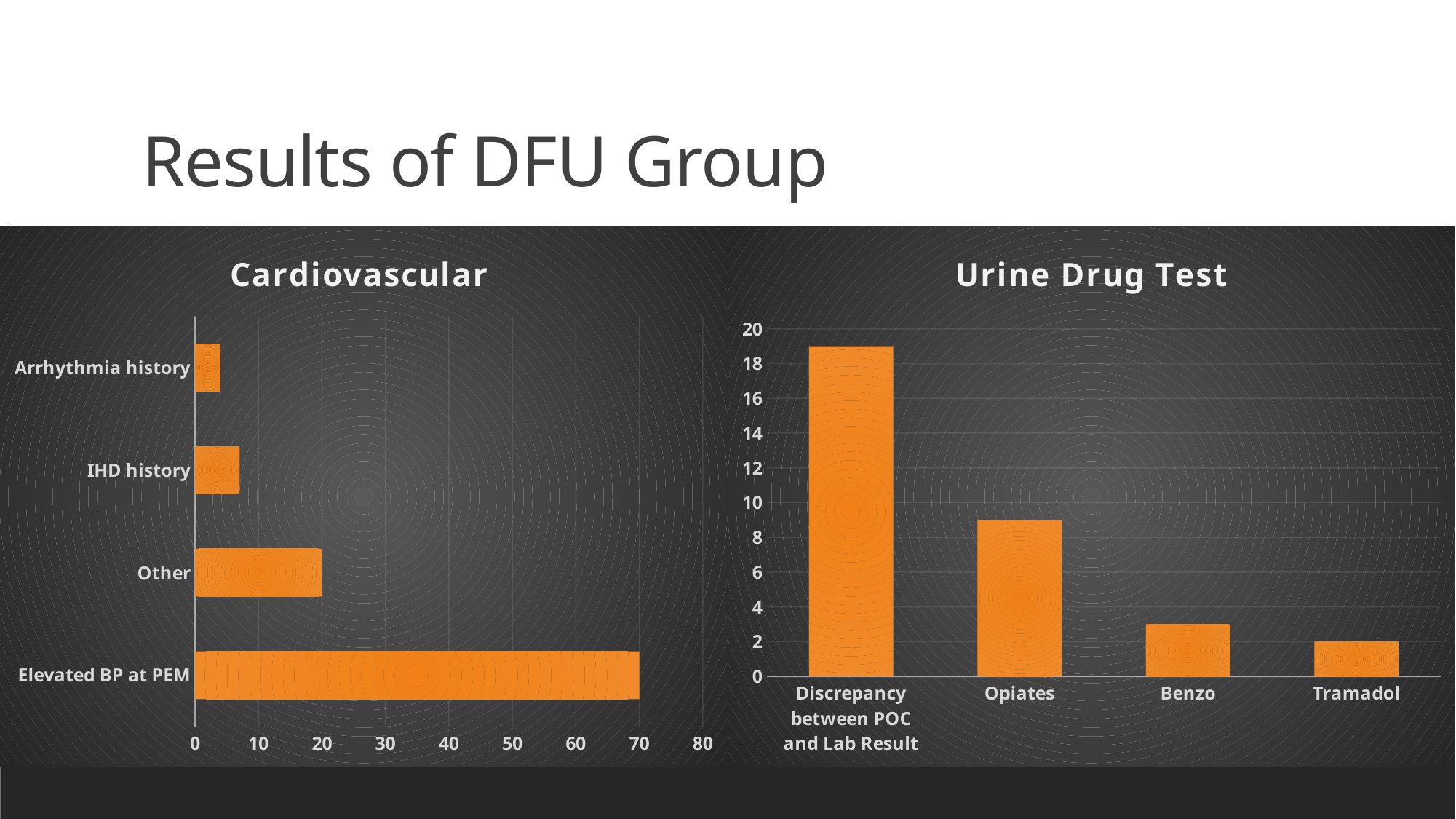
In the Cardiovascular chart, what is the value for Elevated BP at PEM? 70 In the Urine Drug Test chart, is the value for Opiates greater or less than 10? less In the Cardiovascular chart, is the value for IHD history greater or less than 10? less In the Cardiovascular chart, what is the value for Other? 20 In the Cardiovascular chart, how many categories are plotted? 4 In the Urine Drug Test chart, which category has the highest value? Discrepancy between POC and Lab Result In the Cardiovascular chart, what is the difference between the values for Elevated BP at PEM and Other? 50 In the Cardiovascular chart, which category has the highest value? Elevated BP at PEM In the Urine Drug Test chart, which category has the lowest value? Tramadol In the Cardiovascular chart, what kind of chart is shown? bar chart In the Cardiovascular chart, which category has the lowest value? Arrhythmia history In the Urine Drug Test chart, which is larger, the value for Opiates or the value for Benzo? Opiates